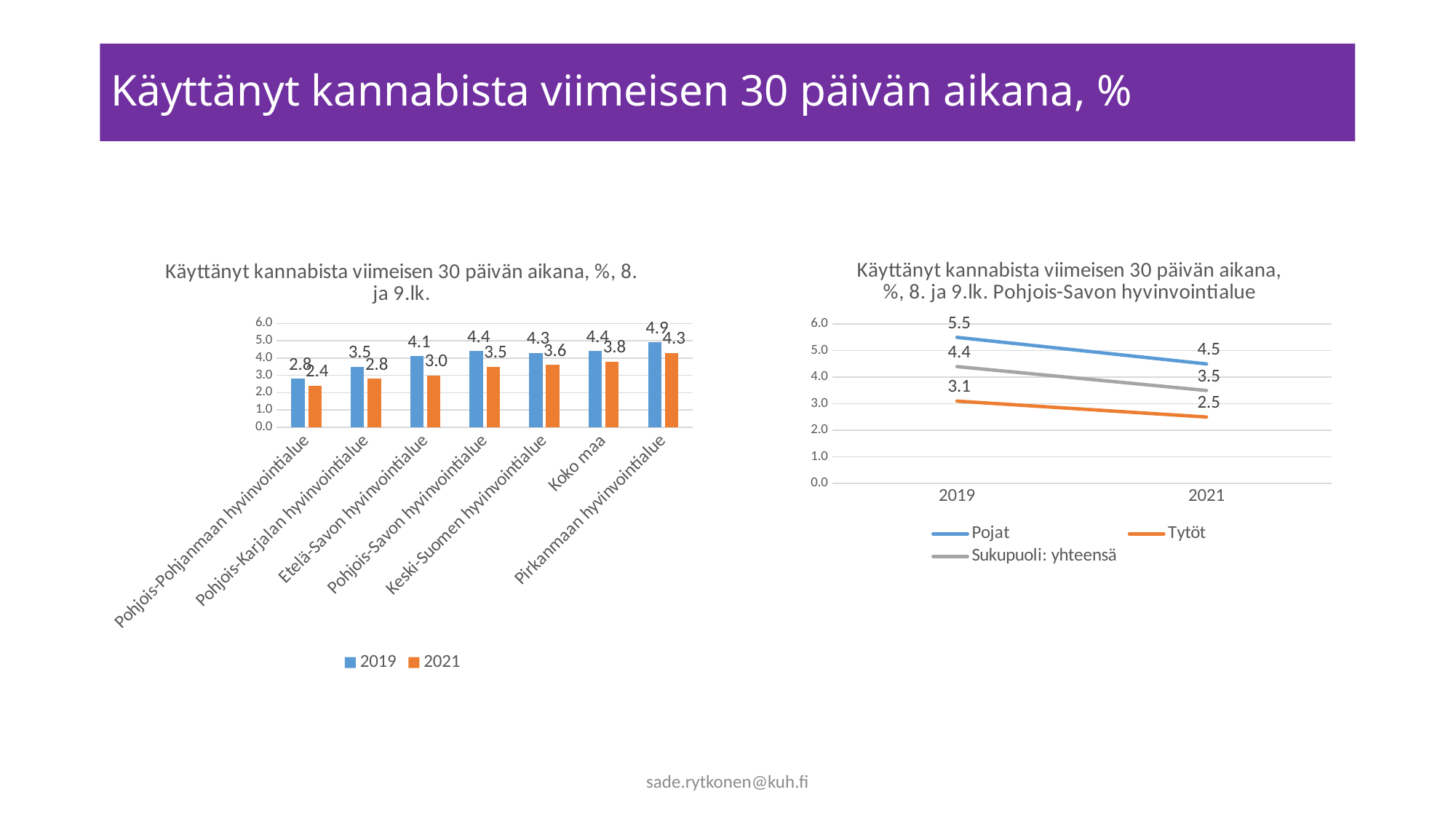
In the left chart, which category has the lowest 2021 value? Pohjois-Pohjanmaan hyvinvointialue In the left chart, what is the 2021 value for Pohjois-Savon hyvinvointialue? 3.5 In the right chart, what is the value for Pojat in 2019? 5.5 In the left chart, what is the 2019 value for Koko maa? 4.4 In the left chart, which category has the highest 2019 value? Pirkanmaan hyvinvointialue In the left chart, what is the difference between the 2019 and 2021 values for Etelä-Savon hyvinvointialue? 1.1 In the right chart, what is the difference between the Pojat and Tytöt values in 2021? 2.0 In the right chart, what is the value for Tytöt in 2021? 2.5 In the right chart, does the value for Sukupuoli: yhteensä rise or fall from 2019 to 2021? Fall What type of chart is the left chart? Bar chart In the left chart, how many categories are shown on the x axis? 7 In the right chart, how many series does the legend list? 3